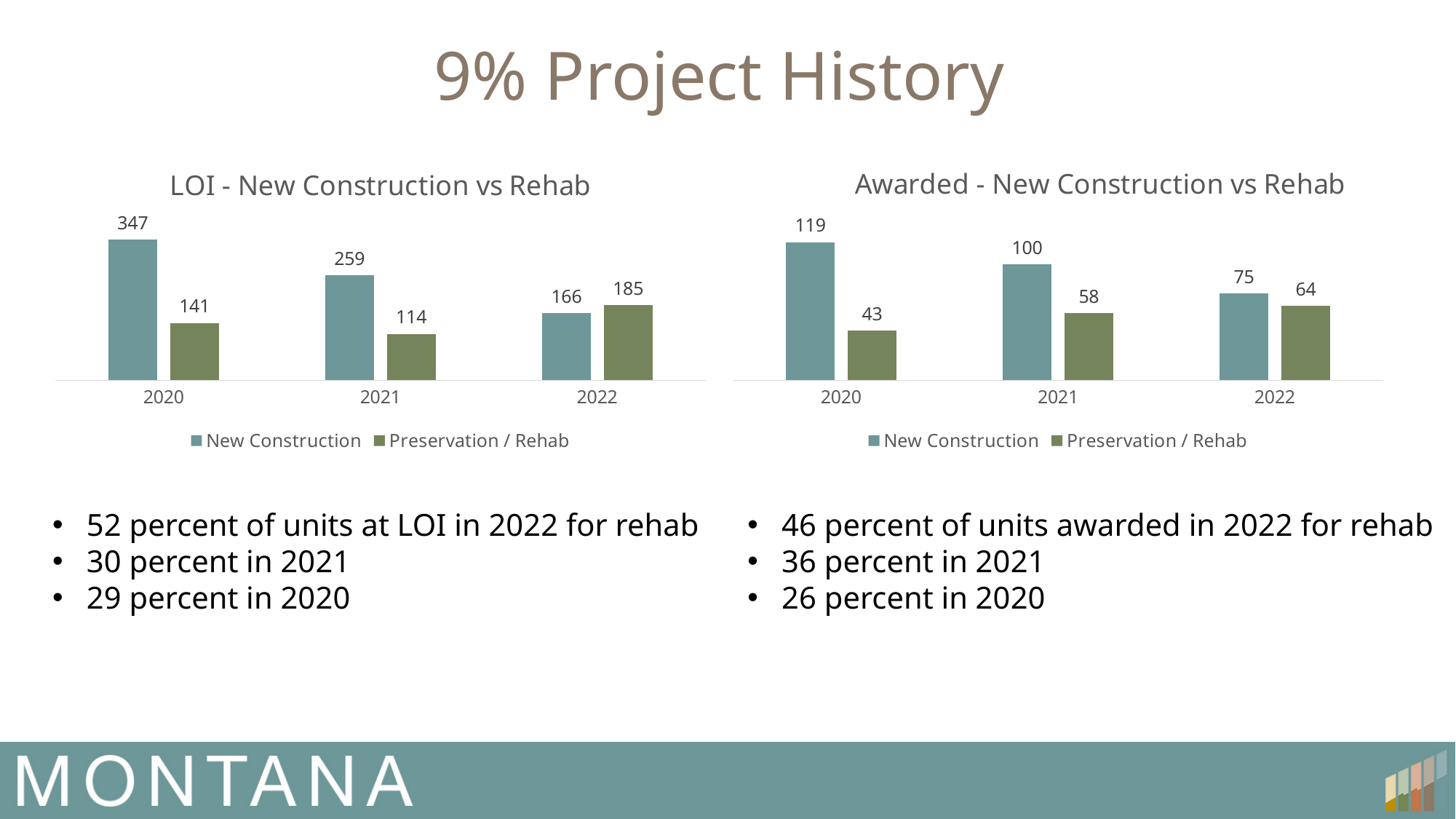
In the 'Awarded - New Construction vs Rehab' chart, do the New Construction values rise or fall from 2020 to 2022? Fall How many series does the legend of the 'Awarded - New Construction vs Rehab' chart list? 2 In the 'LOI - New Construction vs Rehab' chart, what is the difference between New Construction and Preservation / Rehab in 2021? 145 In the 'Awarded - New Construction vs Rehab' chart, what is the difference between New Construction in 2020 and New Construction in 2022? 44 What kind of chart is the 'LOI - New Construction vs Rehab' chart? Bar chart In the 'Awarded - New Construction vs Rehab' chart, what is the value for New Construction in 2021? 100 In the 'LOI - New Construction vs Rehab' chart, which year has the highest New Construction value? 2020 In the 'Awarded - New Construction vs Rehab' chart, what is the value for Preservation / Rehab in 2020? 43 In the 'LOI - New Construction vs Rehab' chart, what is the value for New Construction in 2020? 347 In the 'LOI - New Construction vs Rehab' chart, what is the value for Preservation / Rehab in 2022? 185 In the 'LOI - New Construction vs Rehab' chart, which is larger in 2022: New Construction or Preservation / Rehab? Preservation / Rehab In the 'Awarded - New Construction vs Rehab' chart, which year has the lowest Preservation / Rehab value? 2020